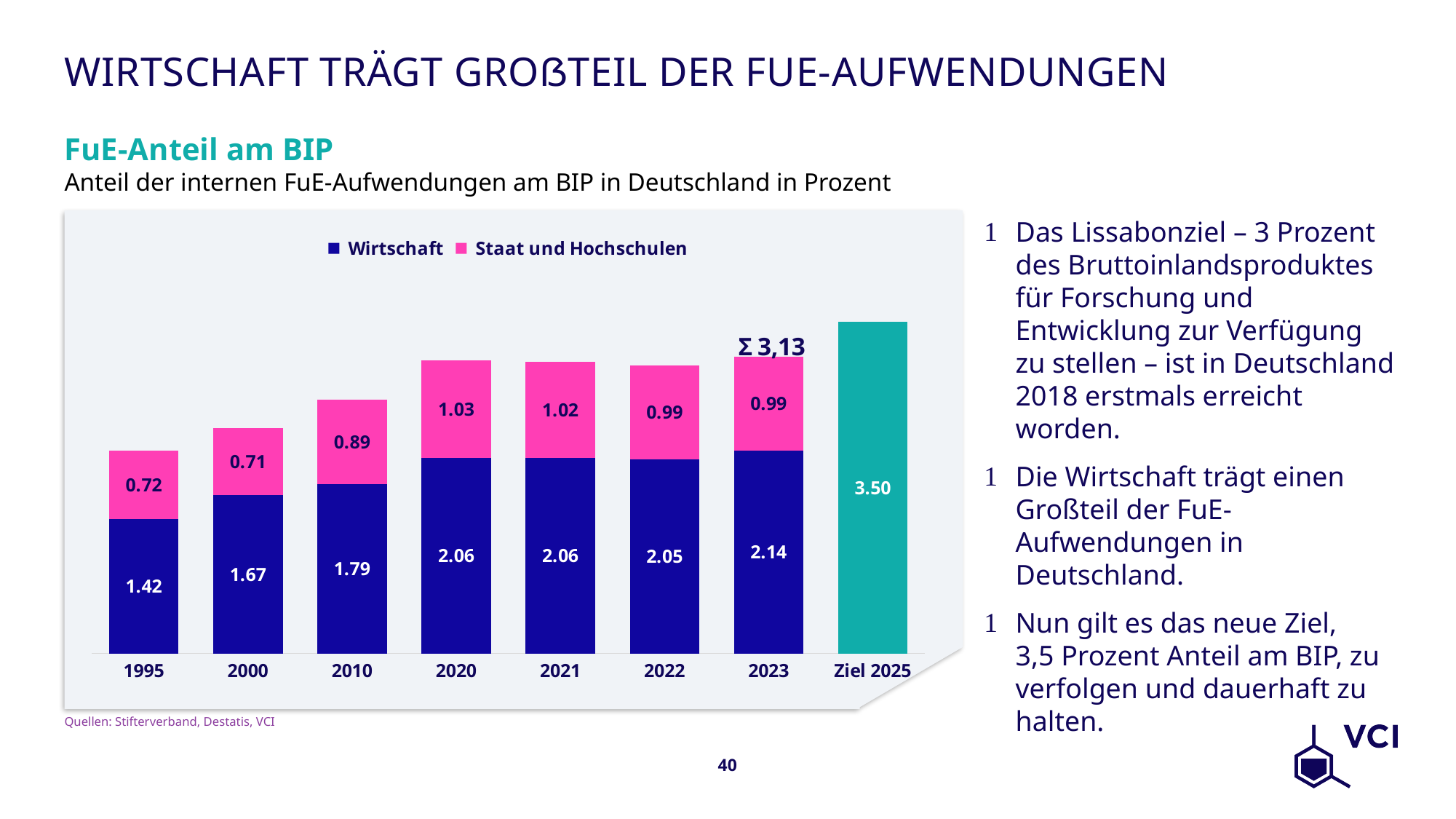
Which year has the larger Wirtschaft value, 2000 or 2010? 2010 What is the Staat und Hochschulen value for 2020? 1.03 What value is shown for the Ziel 2025 bar? 3.50 In which year is the Wirtschaft value the highest? 2023 What is the total shown for the 2023 bar? 3,13 How many categories are shown on the x axis? 8 What is the Wirtschaft value for 2023? 2.14 What is the Wirtschaft value for 1995? 1.42 How many series does the legend list? 2 What kind of chart is shown on the slide? Stacked bar chart In which year is the Wirtschaft value the lowest? 1995 By how much did the Wirtschaft value increase from 1995 to 2023? 0.72